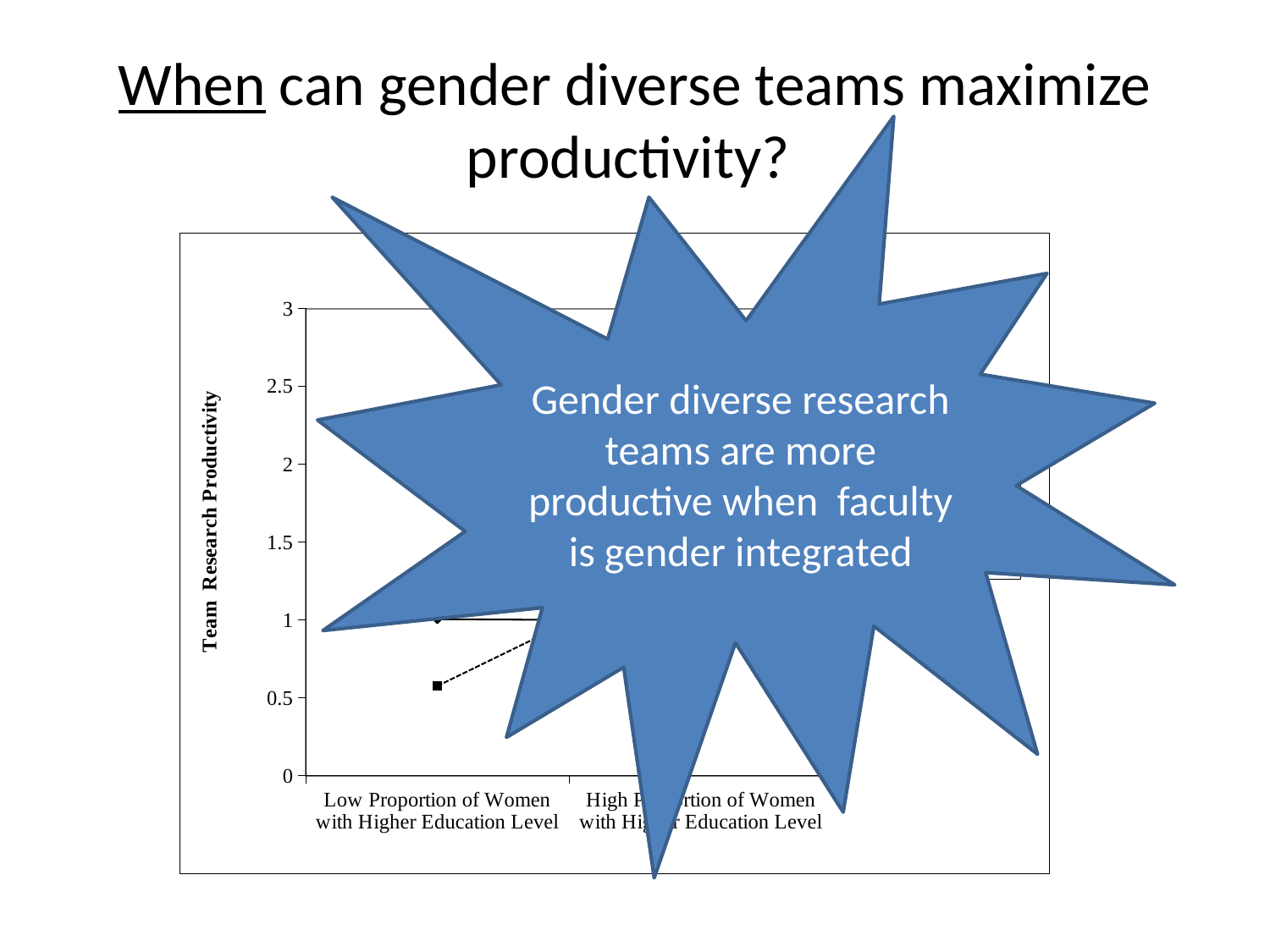
At 'Low Proportion of Women with Higher Education Level', which line has the higher value, the solid line or the dashed line? the solid line Is the value of the dashed line at 'Low Proportion of Women with Higher Education Level' greater or less than 0.5? greater What is the label of the y axis of the chart? Team Research Productivity Is the value of the solid line at 'Low Proportion of Women with Higher Education Level' greater or less than 0.5? greater What is the highest tick value shown on the y axis of the chart? 3 Is the value of the dashed line at 'Low Proportion of Women with Higher Education Level' greater or less than 1? less How many categories are shown on the x axis of the chart? 2 What kind of chart is shown on the slide? line chart Does the dashed line rise or fall moving from the low-proportion category toward the high-proportion category? rise